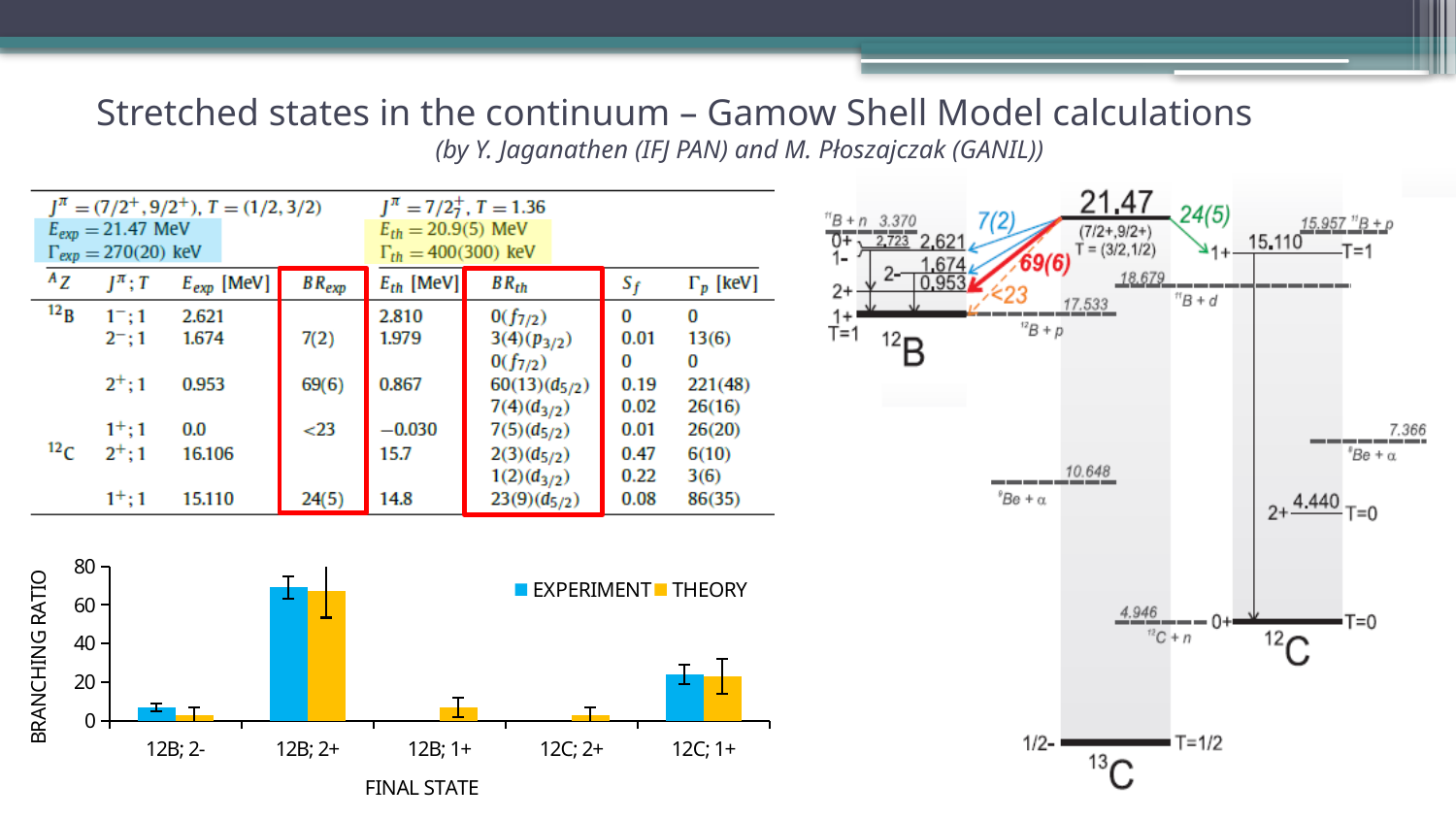
In the branching ratio bar chart, is the EXPERIMENT value for 12B; 2+ greater or less than 60? greater In the branching ratio bar chart, which final state has the highest EXPERIMENT bar? 12B; 2+ How many final-state categories are shown on the x axis of the branching ratio bar chart? 5 In the branching ratio bar chart, is the EXPERIMENT value for 12C; 1+ greater or less than 40? less In the branching ratio bar chart, which EXPERIMENT bar is larger: 12B; 2+ or 12C; 1+? 12B; 2+ In the branching ratio bar chart, which EXPERIMENT bar is larger: 12B; 2- or 12C; 1+? 12C; 1+ In the branching ratio bar chart, is the EXPERIMENT value for 12B; 2- greater or less than 20? less In the branching ratio bar chart, which final state has the highest THEORY bar? 12B; 2+ What is the x-axis title of the branching ratio bar chart? FINAL STATE How many series does the legend of the branching ratio bar chart list? 2 What kind of chart is shown at the bottom left of the slide? bar chart